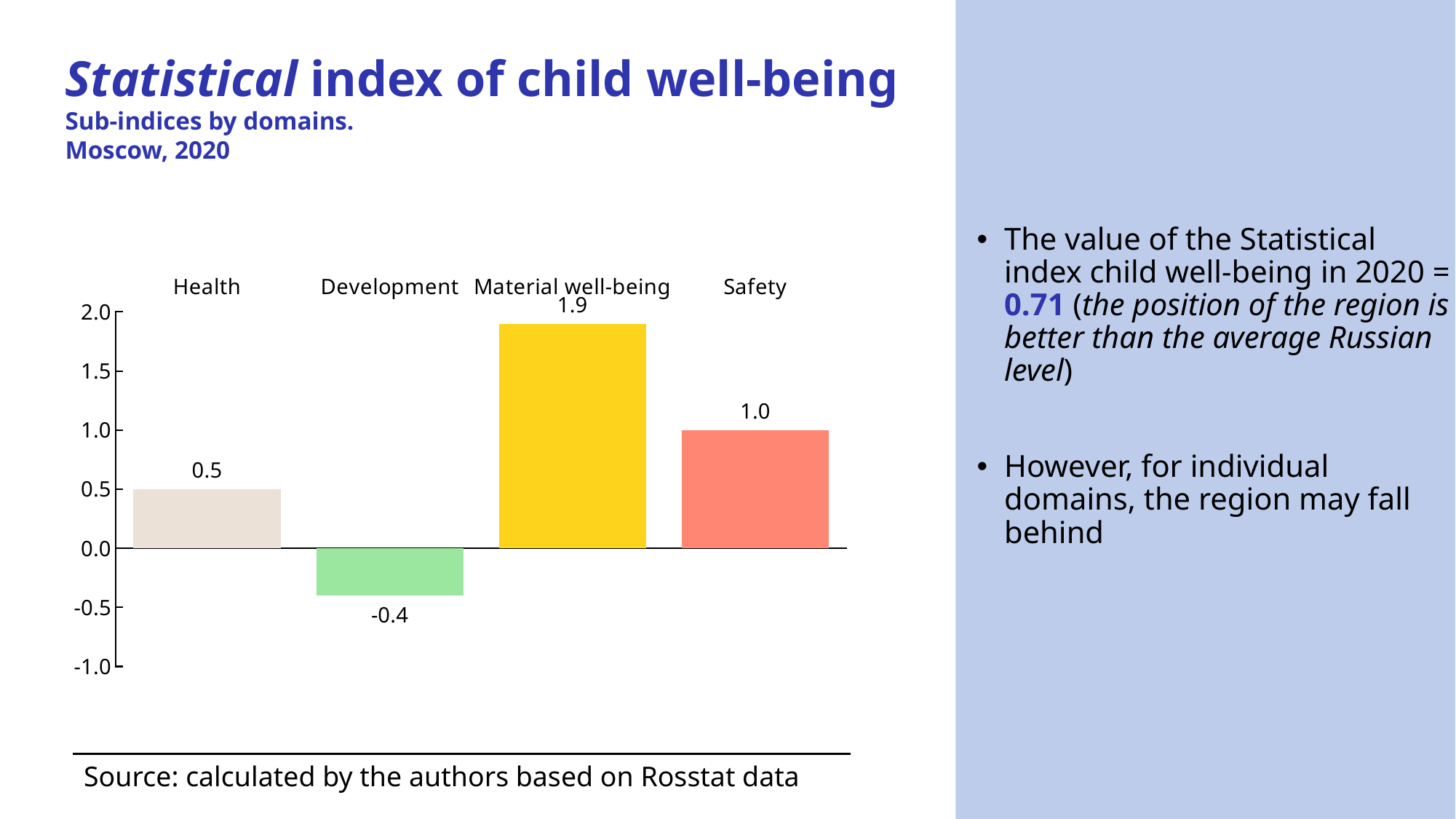
What is the sub-index value for Development? -0.4 How many domains are shown in the chart? 4 What kind of chart is shown on the slide? bar chart Which domain has the highest sub-index value? Material well-being Is the value for Material well-being greater or less than 1.5? greater Which domain is shown with a green bar? Development What is the difference between the Material well-being and Safety sub-index values? 0.9 Which domain has the lowest sub-index value? Development Which is larger, the sub-index for Health or for Safety? Safety What is the sub-index value for Health? 0.5 What is the sub-index value for Material well-being? 1.9 What is the sub-index value for Safety? 1.0